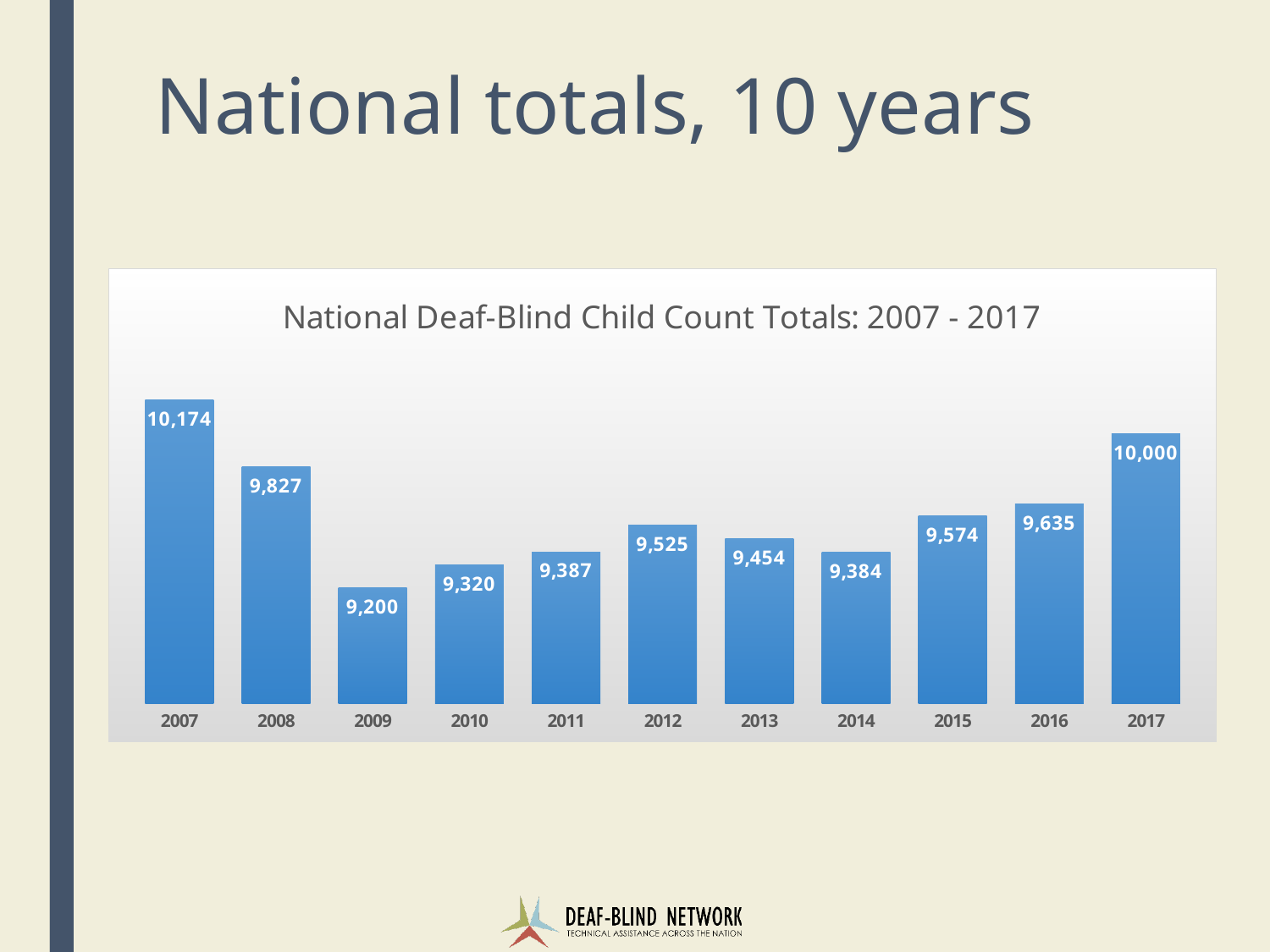
How many years are shown on the chart? 11 Which year has a larger total, 2008 or 2015? 2008 What kind of chart is shown on the slide? Bar chart What is the title of the chart? National Deaf-Blind Child Count Totals: 2007 - 2017 What is the value shown for 2017? 10,000 What is the value shown for 2012? 9,525 Which year has a larger total, 2013 or 2014? 2013 What is the difference between the 2007 total and the 2009 total? 974 Which year has the highest total? 2007 What is the national deaf-blind child count total for 2007? 10,174 Which year has the lowest total? 2009 What is the difference between the 2017 total and the 2016 total? 365